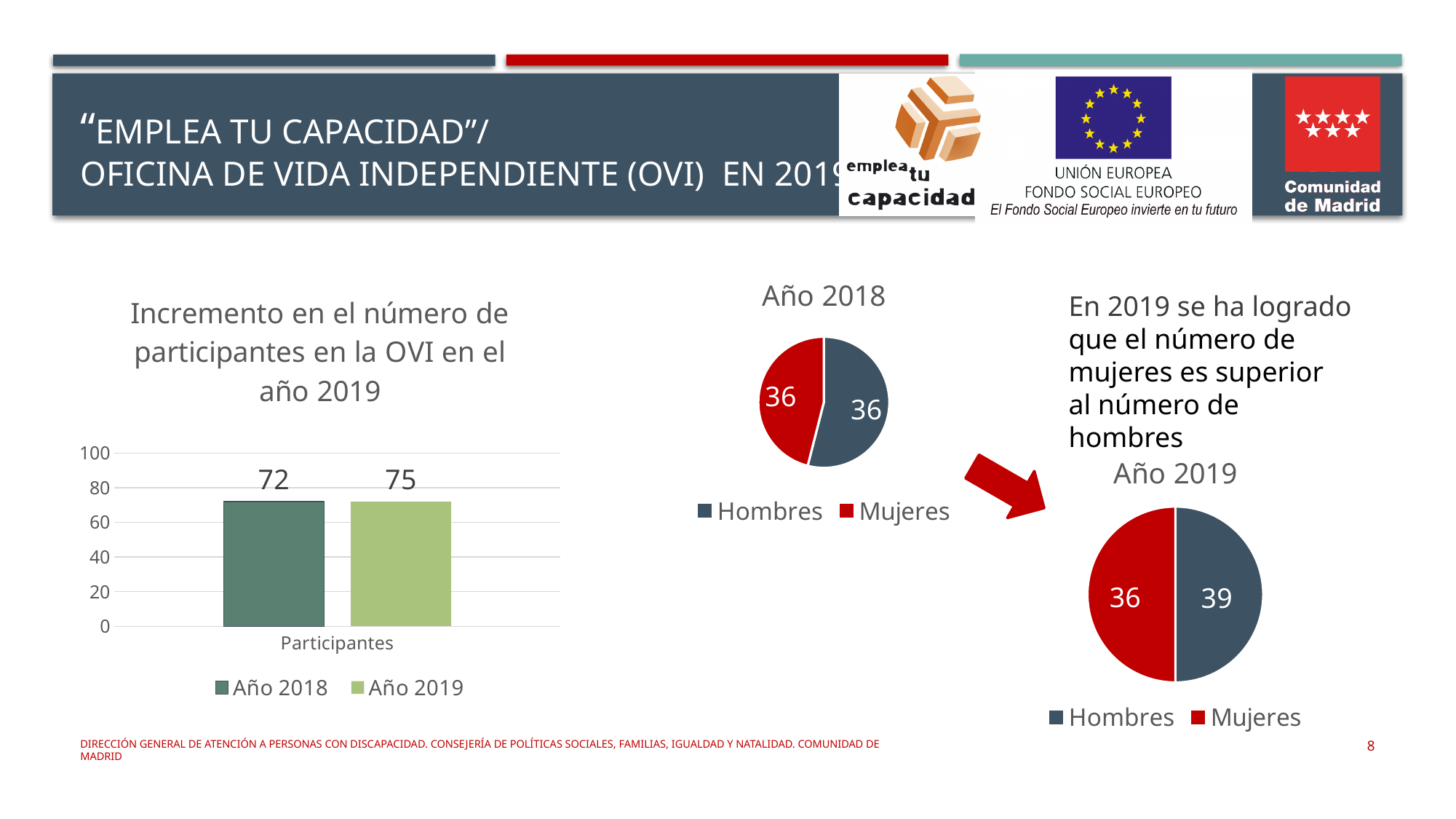
What kind of chart is the chart titled 'Incremento en el número de participantes en la OVI en el año 2019'? bar chart In the pie chart 'Año 2019', what is the value for Mujeres? 36 In the pie chart 'Año 2019', which colour represents Mujeres? red How many series does the legend of the bar chart on the left list? 2 In the bar chart on the left, by how much did the number of participants increase from Año 2018 to Año 2019? 3 In the pie chart 'Año 2019', what is the value for Hombres? 39 In the pie chart 'Año 2019', what is the difference between the Hombres and Mujeres values? 3 In the bar chart on the left, which series has the higher value, Año 2018 or Año 2019? Año 2019 In the pie chart 'Año 2018', what is the value for Hombres? 36 In the bar chart 'Incremento en el número de participantes en la OVI en el año 2019', what is the value for Año 2018? 72 In the bar chart 'Incremento en el número de participantes en la OVI en el año 2019', what is the value for Año 2019? 75